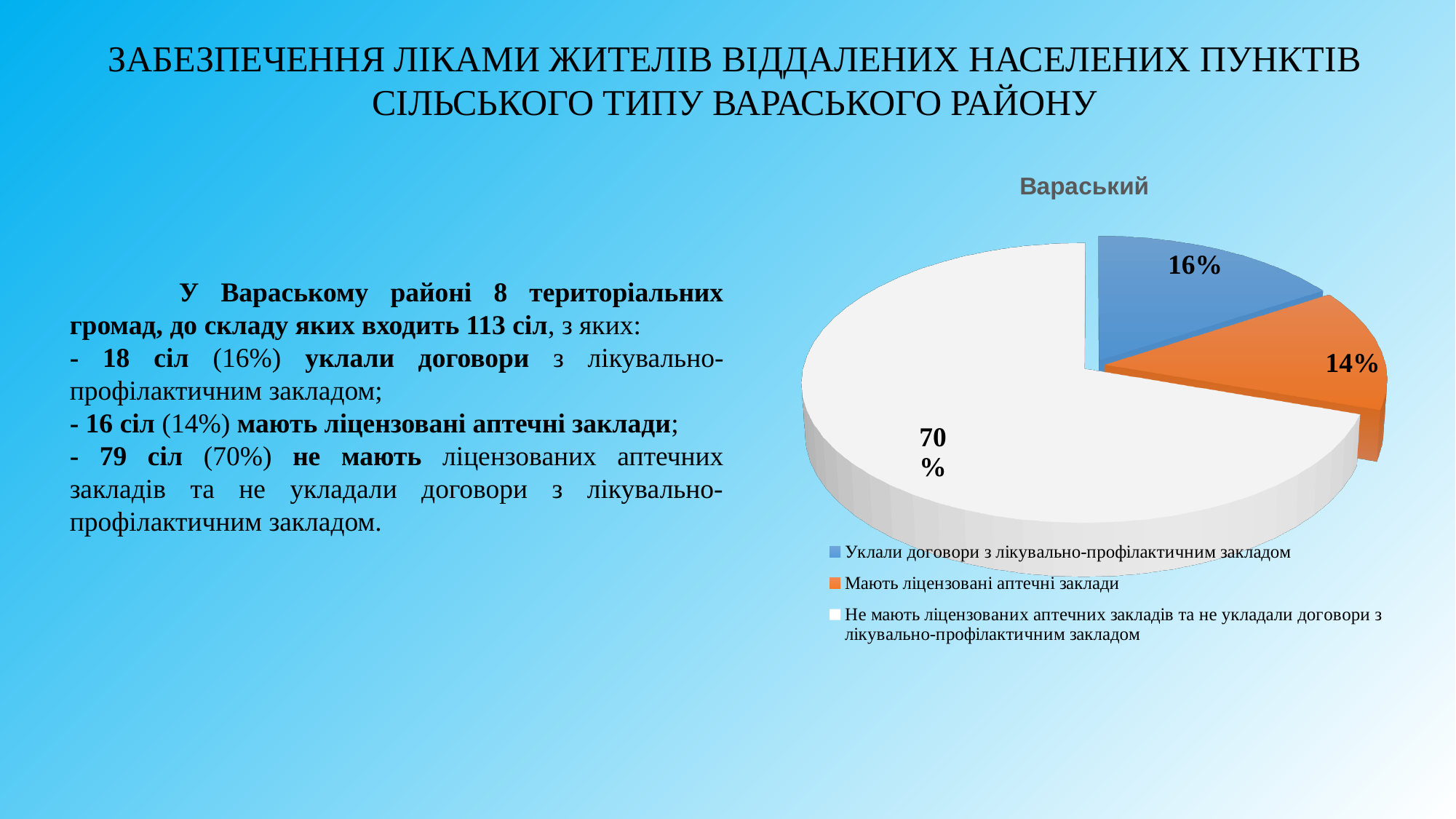
What share of the pie is labelled 'Не мають ліцензованих аптечних закладів та не укладали договори з лікувально-профілактичним закладом'? 70% What is the difference in percentage points between the 'Уклали договори з лікувально-профілактичним закладом' slice and the 'Мають ліцензовані аптечні заклади' slice? 2% What is the difference in percentage points between the largest slice and the 'Уклали договори з лікувально-профілактичним закладом' slice? 54% Which category has the smallest slice of the pie? Мають ліцензовані аптечні заклади What kind of chart is shown on the slide? pie chart What share of the pie is labelled 'Уклали договори з лікувально-профілактичним закладом'? 16% What is the title of the chart? Вараський What share of the pie is labelled 'Мають ліцензовані аптечні заклади'? 14% What colour is the slice for 'Мають ліцензовані аптечні заклади'? orange Which is larger: the 'Уклали договори з лікувально-профілактичним закладом' slice or the 'Мають ліцензовані аптечні заклади' slice? Уклали договори з лікувально-профілактичним закладом How many categories does the pie chart have? 3 Which category has the largest slice of the pie? Не мають ліцензованих аптечних закладів та не укладали договори з лікувально-профілактичним закладом